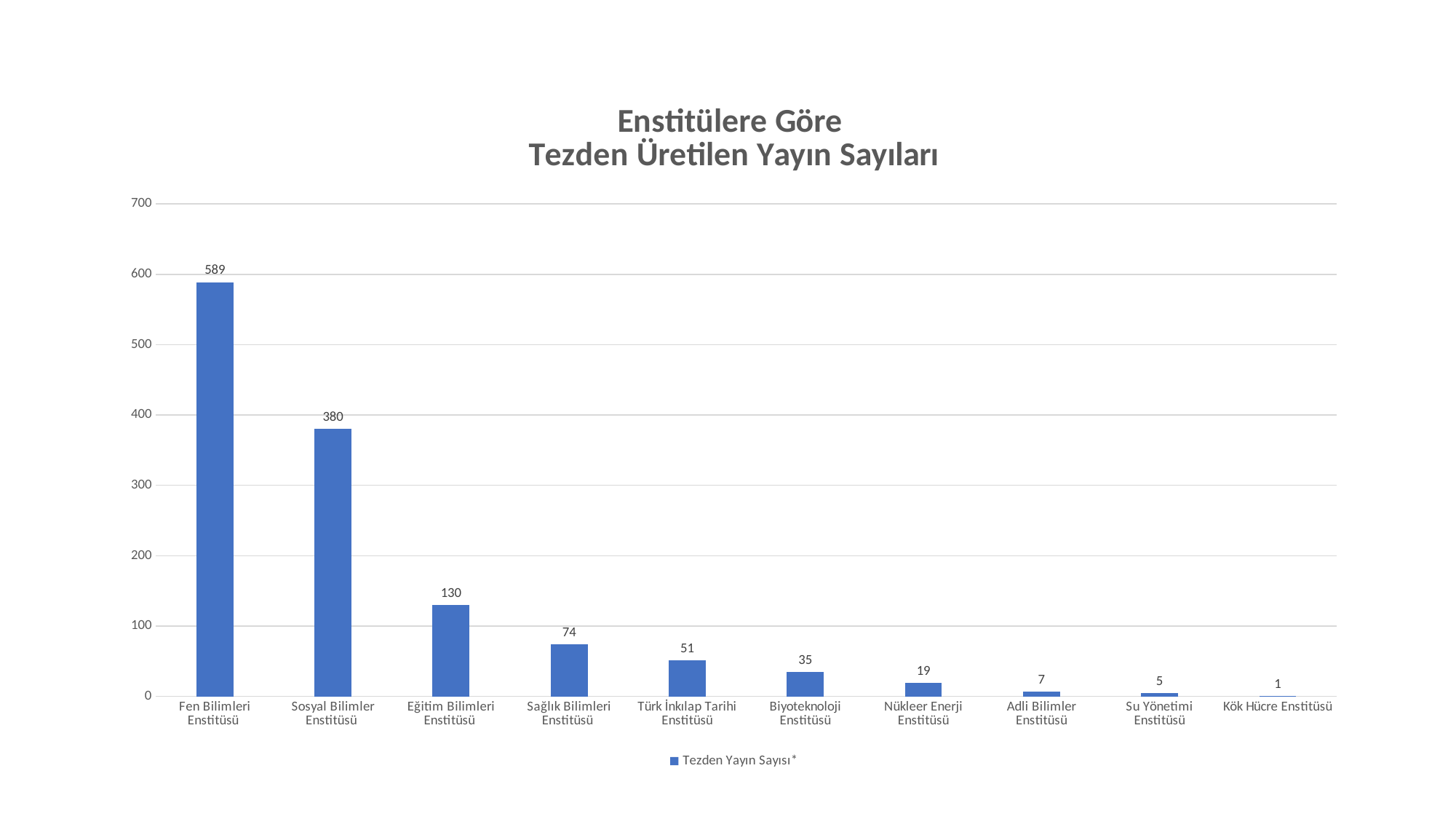
Which is larger, the value for Eğitim Bilimleri Enstitüsü or Biyoteknoloji Enstitüsü? Eğitim Bilimleri Enstitüsü What is the difference between the values for Fen Bilimleri Enstitüsü and Sosyal Bilimler Enstitüsü? 209 Which institute has the highest number of publications? Fen Bilimleri Enstitüsü What is the value for Sağlık Bilimleri Enstitüsü? 74 Which institute has the lowest number of publications? Kök Hücre Enstitüsü Is the value for Sosyal Bilimler Enstitüsü greater or less than 300? greater What is the legend entry of the chart? Tezden Yayın Sayısı* How many series does the legend list? 1 What kind of chart is shown? bar chart What is the value for Nükleer Enerji Enstitüsü? 19 What is the value for Fen Bilimleri Enstitüsü? 589 How many institutes are shown on the x axis? 10